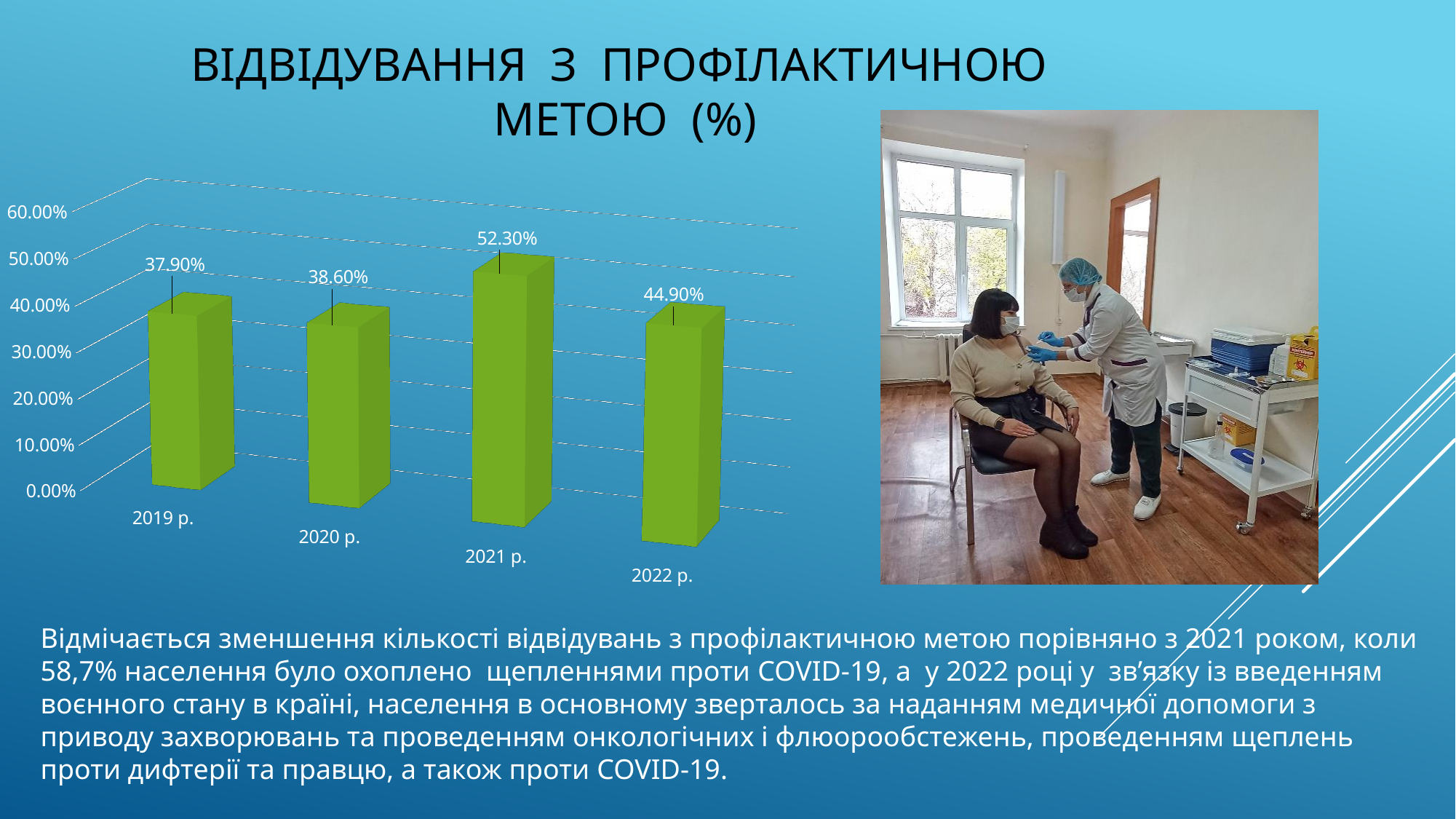
Which year has the lowest value? 2019 р. Is the value for 2021 р. greater or less than 50.00%? greater What is the value for 2022 р.? 44.90% How many years are shown on the chart? 4 Which year has the highest value? 2021 р. What kind of chart is shown on the slide? bar chart What is the value for 2019 р.? 37.90% What is the value for 2020 р.? 38.60% Which is larger, the value for 2022 р. or the value for 2020 р.? 2022 р. What is the value for 2021 р.? 52.30% What is the difference between the values for 2021 р. and 2019 р.? 14.40% What is the difference between the values for 2021 р. and 2022 р.? 7.40%